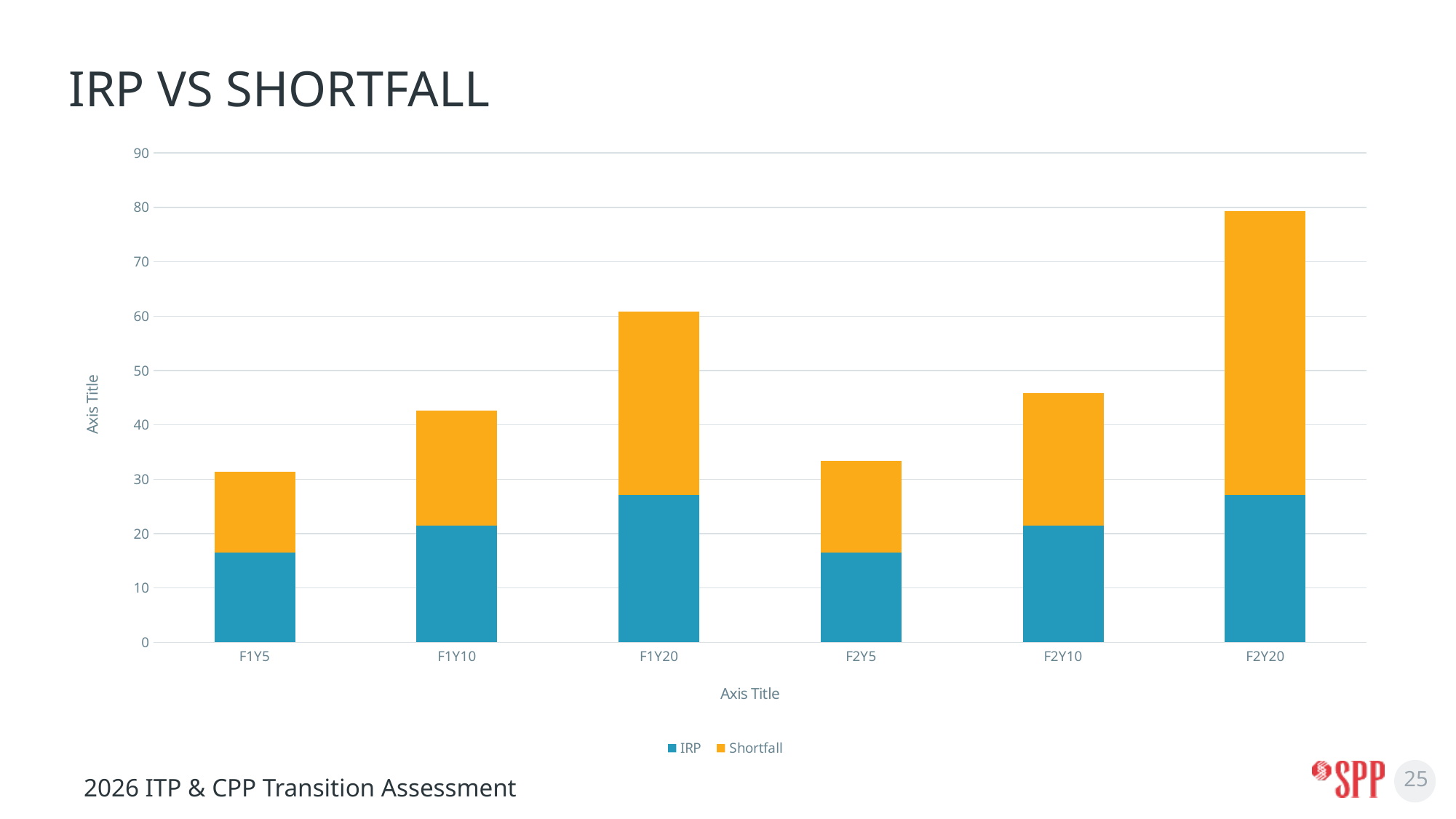
Is the IRP value for F1Y20 greater or less than 20? greater Which series is shown in orange? Shortfall Is the IRP value for F1Y5 greater or less than 20? less Is the total bar for F1Y5 greater or less than 40? less Which category has the highest total bar? F2Y20 How many categories are shown on the x axis? 6 Which has the larger total bar, F1Y20 or F2Y10? F1Y20 What is the title of the chart? IRP VS SHORTFALL What kind of chart is shown on the slide? Stacked bar chart How many series does the legend list? 2